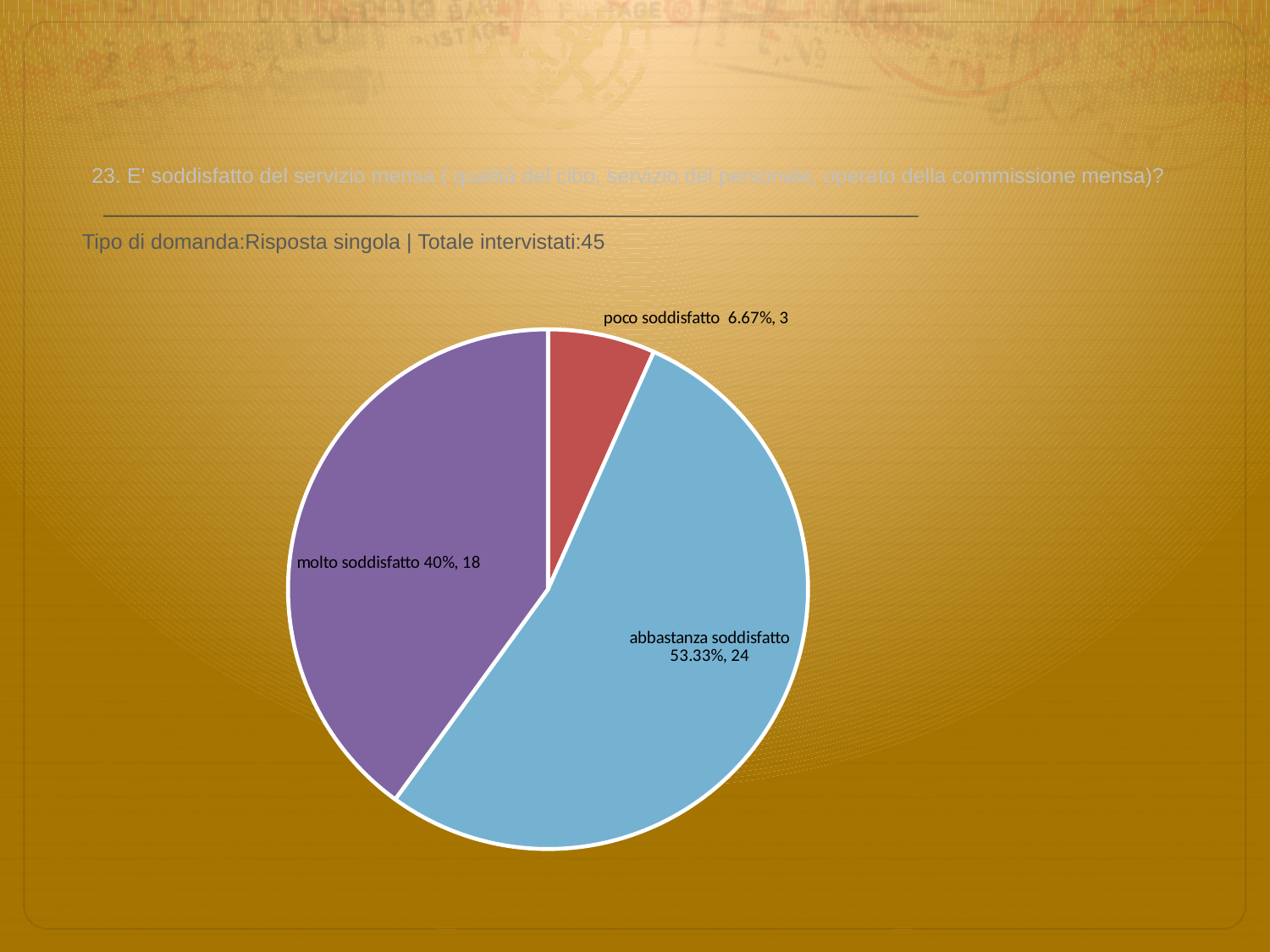
How many respondents answered "poco soddisfatto"? 3 What percentage is shown for "abbastanza soddisfatto"? 53.33% How many respondents answered "molto soddisfatto"? 18 Which category has the largest slice of the pie? abbastanza soddisfatto What is the difference in respondent count between "abbastanza soddisfatto" and "molto soddisfatto"? 6 How many slices does the pie chart have? 3 Which category has the smallest slice of the pie? poco soddisfatto Which has more respondents, "molto soddisfatto" or "poco soddisfatto"? molto soddisfatto What kind of chart is shown on the slide? pie chart What is the total number of respondents across all slices of the pie? 45 What percentage is shown for "poco soddisfatto"? 6.67% What colour is the "molto soddisfatto" slice? purple